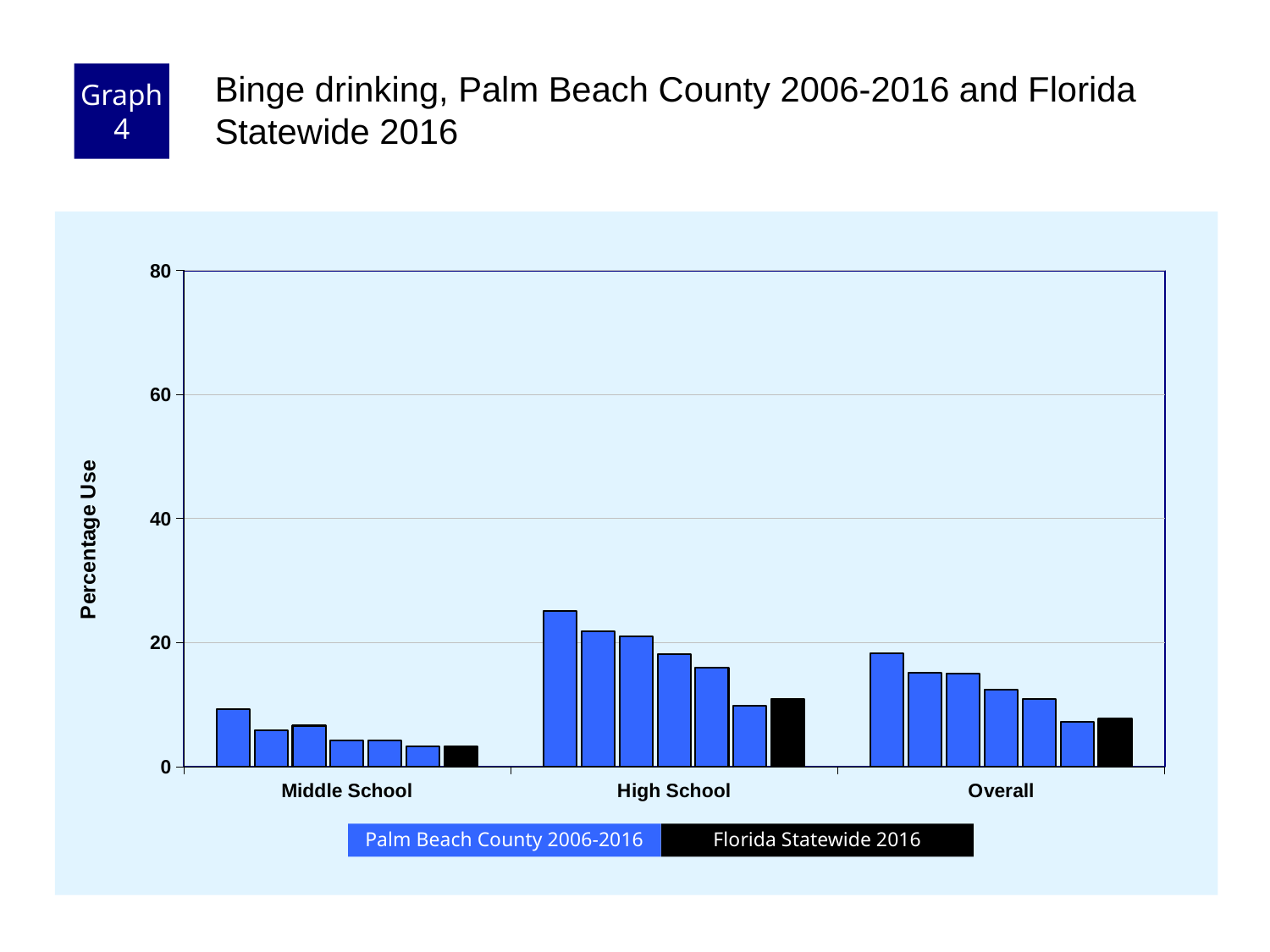
What is the label on the y axis of the chart? Percentage Use Which colour represents Florida Statewide 2016 in the chart's legend? black How many categories are shown on the x axis of the chart? 3 Within the High School category, do the Palm Beach County 2006-2016 bars rise or fall from left to right? fall Which is larger: the Florida Statewide 2016 value for High School or for Middle School? High School Is the value of the tallest Palm Beach County 2006-2016 bar for High School greater or less than 20? greater Which category has the tallest bars in the chart? High School What kind of chart is shown on the slide? bar chart Which category has the shortest bars in the chart? Middle School Is the Florida Statewide 2016 value for Middle School greater or less than 20? less How many series does the chart's legend list? 2 Is the Florida Statewide 2016 value for High School greater or less than 20? less